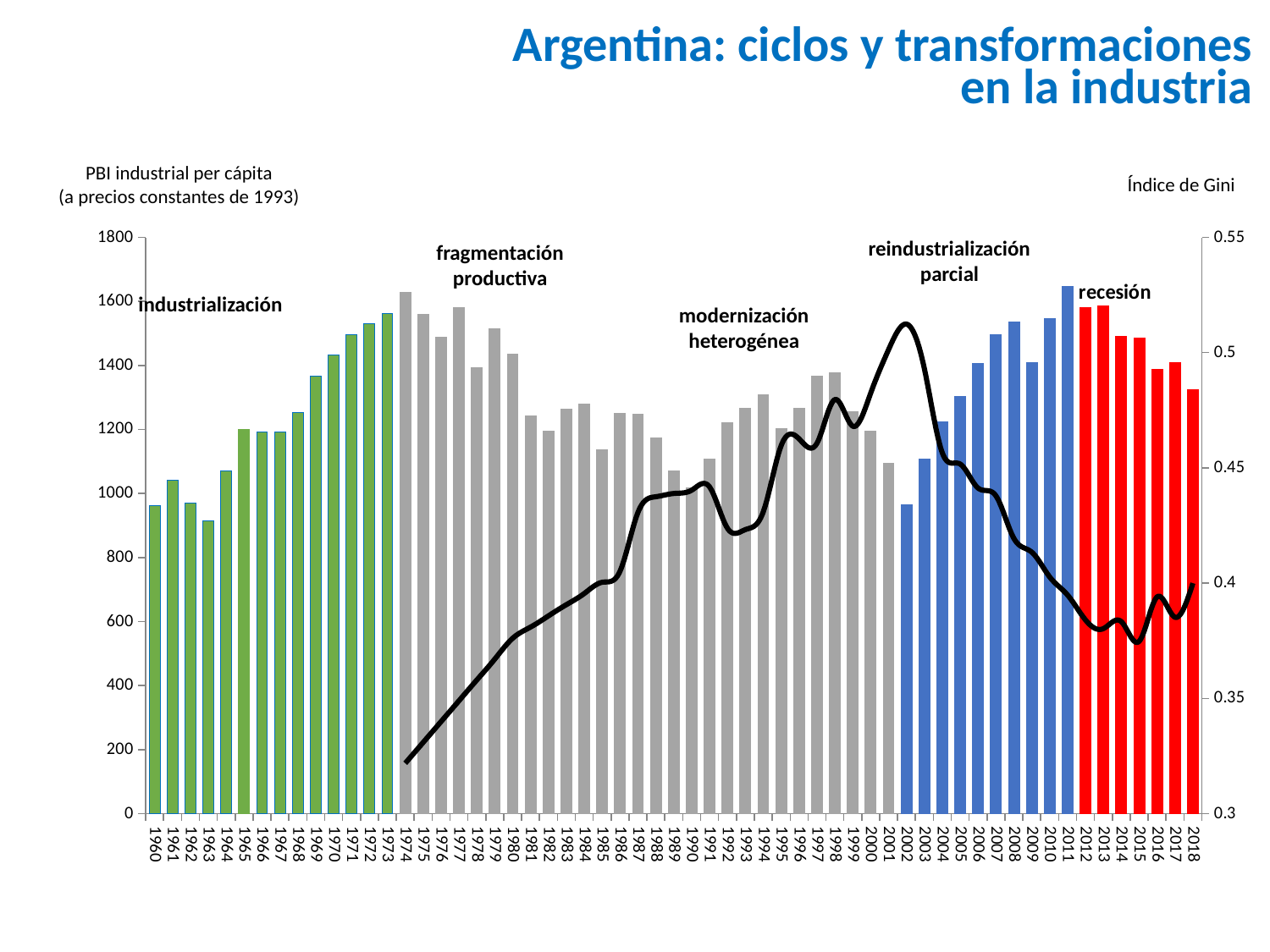
How many years (bars) are shown on the x axis, from 1960 to 2018? 59 Is the PBI industrial per cápita bar for 1960 greater or less than 1000? less What colour are the bars for the years 2012 to 2018? red Which year has the lowest PBI industrial per cápita bar? 1963 Which bar is taller, 2011 or 2002? 2011 Does the Índice de Gini line rise or fall between 1974 and 2002? rise Is the Índice de Gini value at its 2002 peak greater or less than 0.5? greater Is the PBI industrial per cápita bar for 1974 greater or less than 1600? greater What kind of chart is shown on the slide? bar chart with a line overlay What does the right-hand axis of the chart measure? Índice de Gini